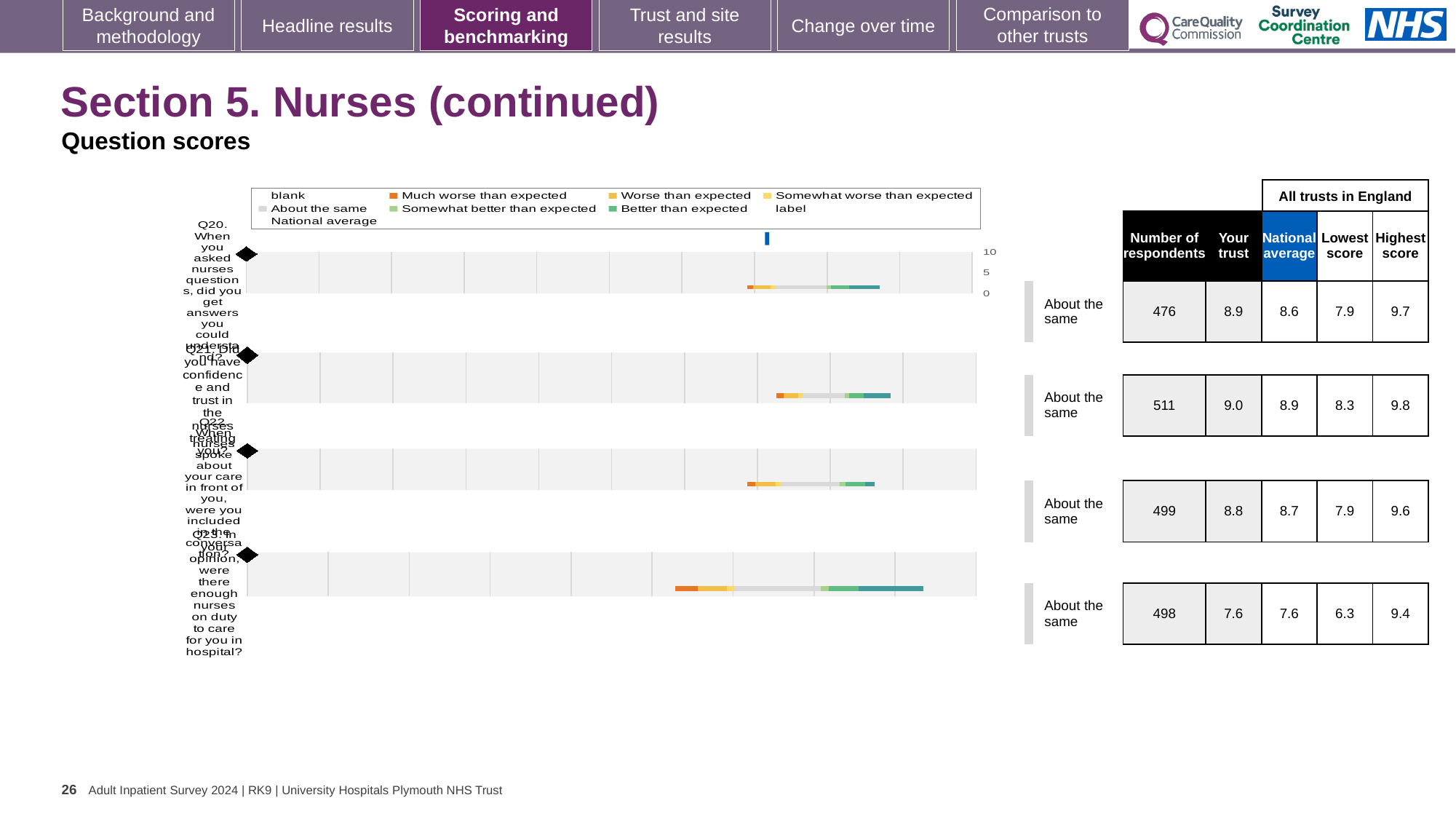
Is the 'Your trust' score for Q23 greater or less than 5 on the chart axis? greater Which has the larger 'Your trust' score, Q21 or Q22? Q21 What is the difference between the 'Your trust' score and the national average for Q20? 0.3 Which question has the lowest 'Your trust' score? Q23 What is the national average score for Q21 (did you have confidence and trust in the nurses treating you)? 8.9 What is the 'Your trust' score for Q23 (were there enough nurses on duty to care for you in hospital)? 7.6 What kind of chart is used to show the question scores on this slide? bar chart Which question has the highest 'Your trust' score? Q21 What benchmark category is shown for all four questions on this slide? About the same How many respondents answered Q20 (when you asked nurses questions, did you get answers you could understand)? 476 What is the highest score among all trusts in England for Q22? 9.6 How many questions (Q20 to Q23) are plotted in the chart? 4